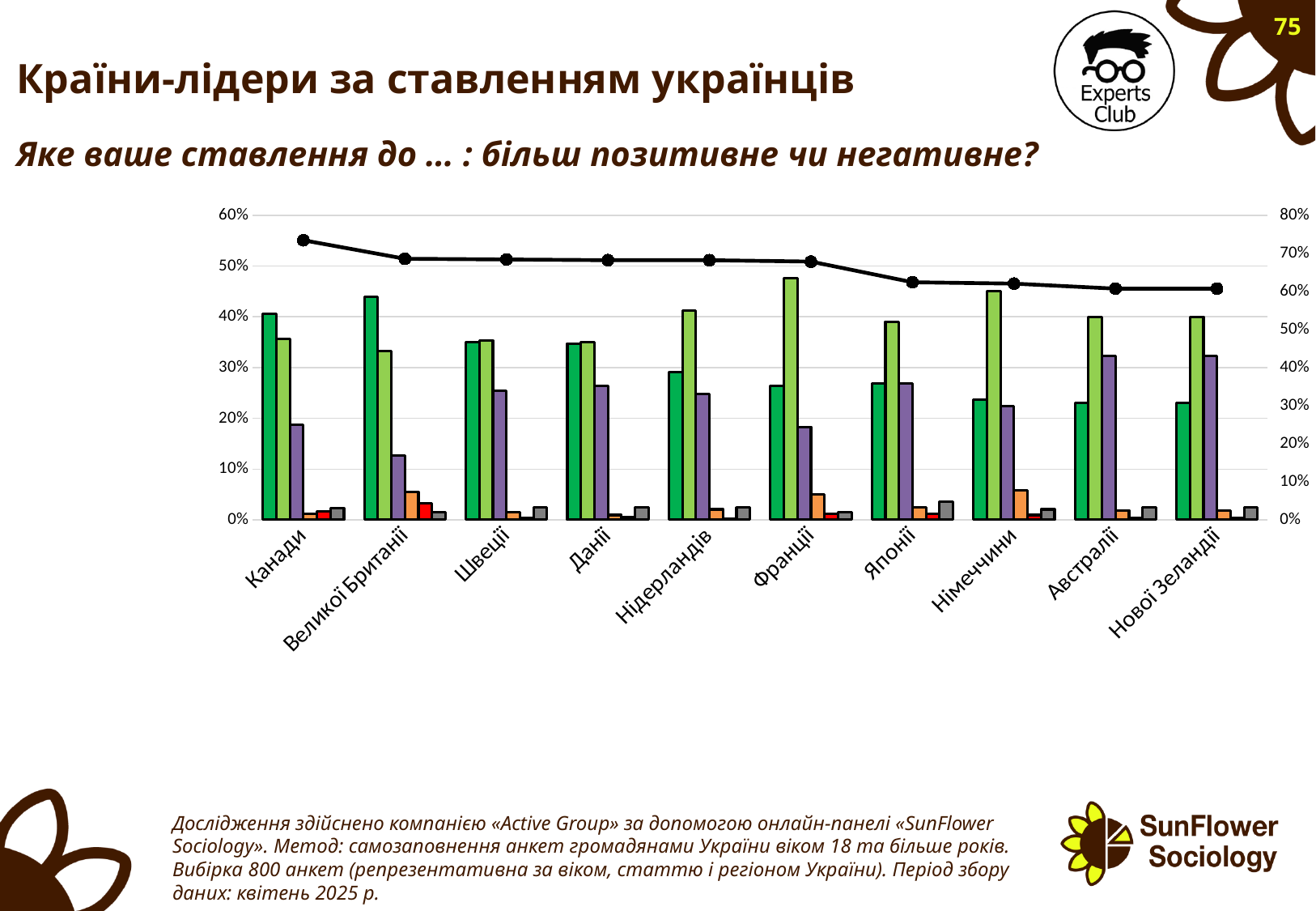
Is the light green bar for Німеччини greater or less than 40%? greater Is the purple bar for Великої Британії greater or less than 20%? less How many countries are listed along the x axis of the chart? 10 Is the light green bar for Франції greater or less than 40%? greater For which country is the black line at its highest point? Канади Which is larger: the purple bar for Австралії or the purple bar for Канади? The purple bar for Австралії For Франції, which is larger: the dark green bar or the light green bar? The light green bar What is the title of the slide containing the chart? Країни-лідери за ставленням українців Does the black line rise or fall as you move from Канади to Нової Зеландії along the x axis? It falls What kind of chart is shown on the slide? A bar chart combined with a line